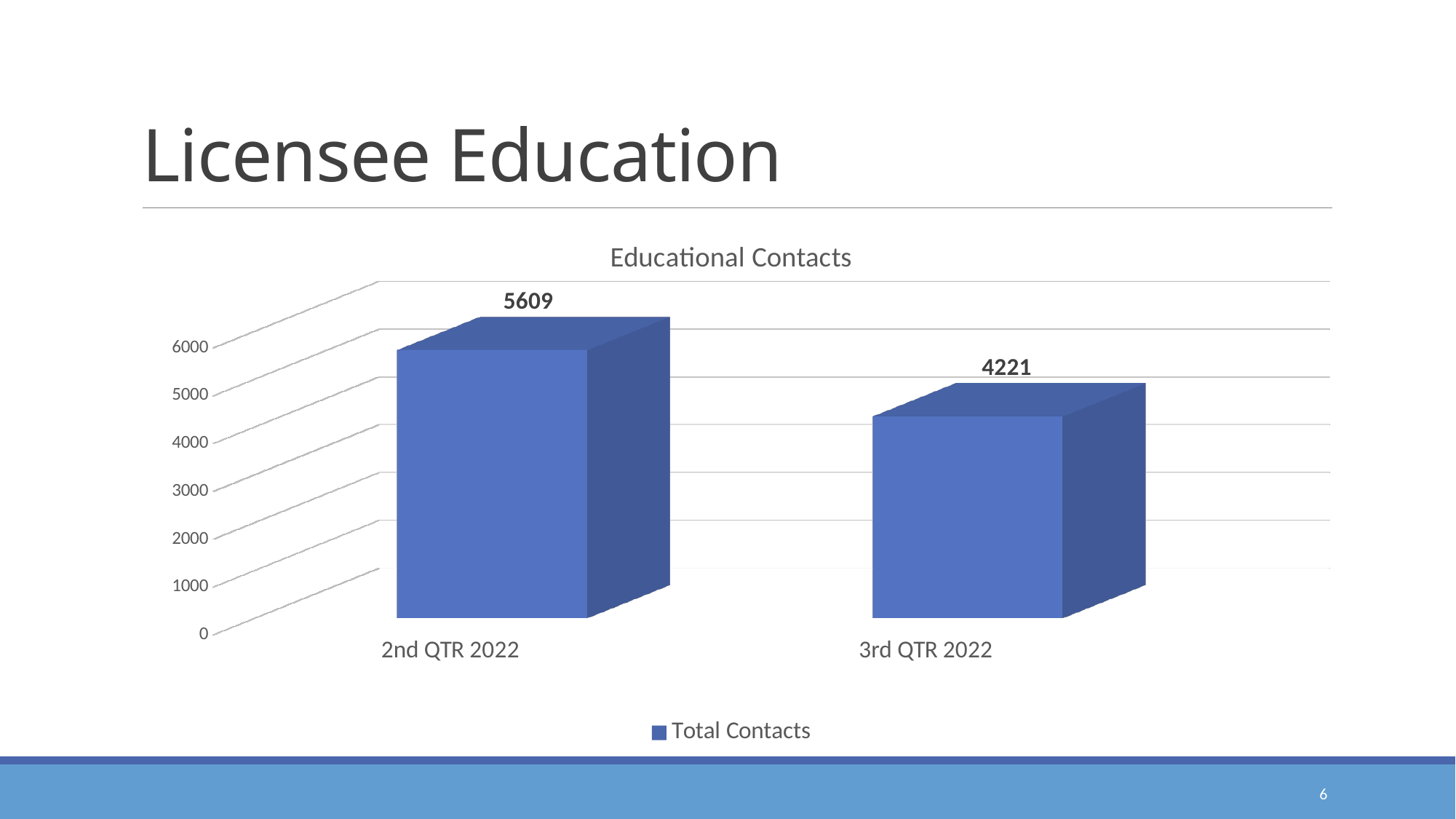
Which quarter has the highest Total Contacts? 2nd QTR 2022 Which quarter has the lowest Total Contacts? 3rd QTR 2022 Is the value for 3rd QTR 2022 greater or less than 5000? less Do the values rise or fall from 2nd QTR 2022 to 3rd QTR 2022? fall What is the value of Total Contacts for 2nd QTR 2022? 5609 What is the difference in Total Contacts between 2nd QTR 2022 and 3rd QTR 2022? 1388 Which is larger, Total Contacts for 2nd QTR 2022 or for 3rd QTR 2022? 2nd QTR 2022 What is the title of the chart? Educational Contacts What is the value of Total Contacts for 3rd QTR 2022? 4221 How many series does the legend list? 1 How many categories are shown on the x axis? 2 What kind of chart is shown on the slide? bar chart